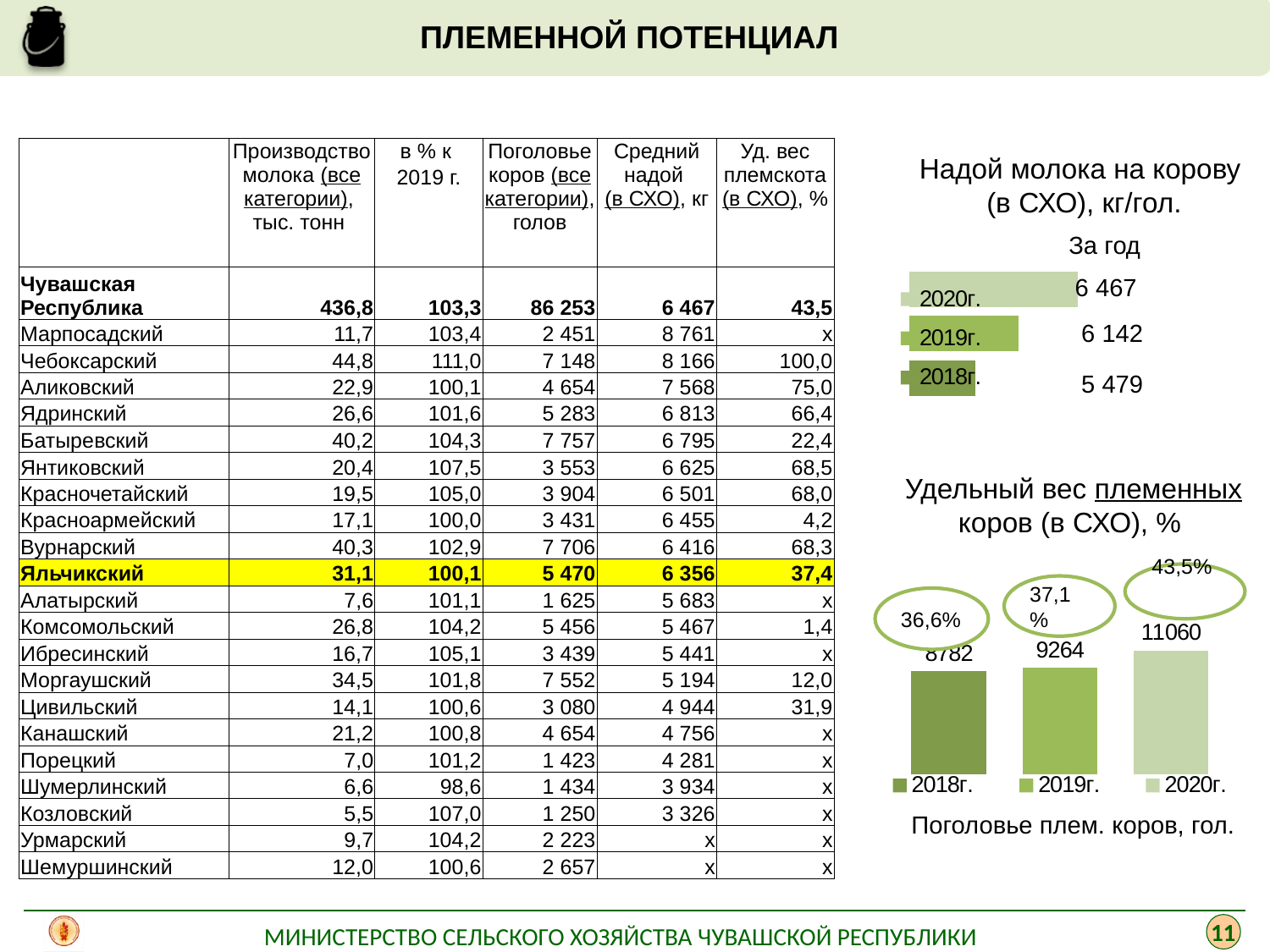
In the chart 'Надой молока на корову (в СХО), кг/гол.', which year has the lowest value? 2018г. In the chart 'Поголовье плем. коров, гол.', what is the difference between the 2020г. and 2018г. values? 2278 What kind of chart is 'Надой молока на корову (в СХО), кг/гол.'? bar chart In the chart 'Поголовье плем. коров, гол.', which year has the highest value? 2020г. In the chart 'Поголовье плем. коров, гол.', what is the value for 2019г.? 9264 In the chart 'Поголовье плем. коров, гол.', do the values rise or fall from 2018г. to 2020г.? rise In the chart 'Надой молока на корову (в СХО), кг/гол.', how many years are shown? 3 In the chart 'Удельный вес племенных коров (в СХО), %', what share is shown for 2020г.? 43,5% In the chart 'Надой молока на корову (в СХО), кг/гол.', what is the difference between the 2020г. and 2019г. values? 325 In the chart 'Поголовье плем. коров, гол.', which is larger: the value for 2019г. or for 2018г.? 2019г. In the chart 'Надой молока на корову (в СХО), кг/гол.', what is the value for 2018г.? 5 479 In the chart 'Надой молока на корову (в СХО), кг/гол.', what is the value for 2020г.? 6 467